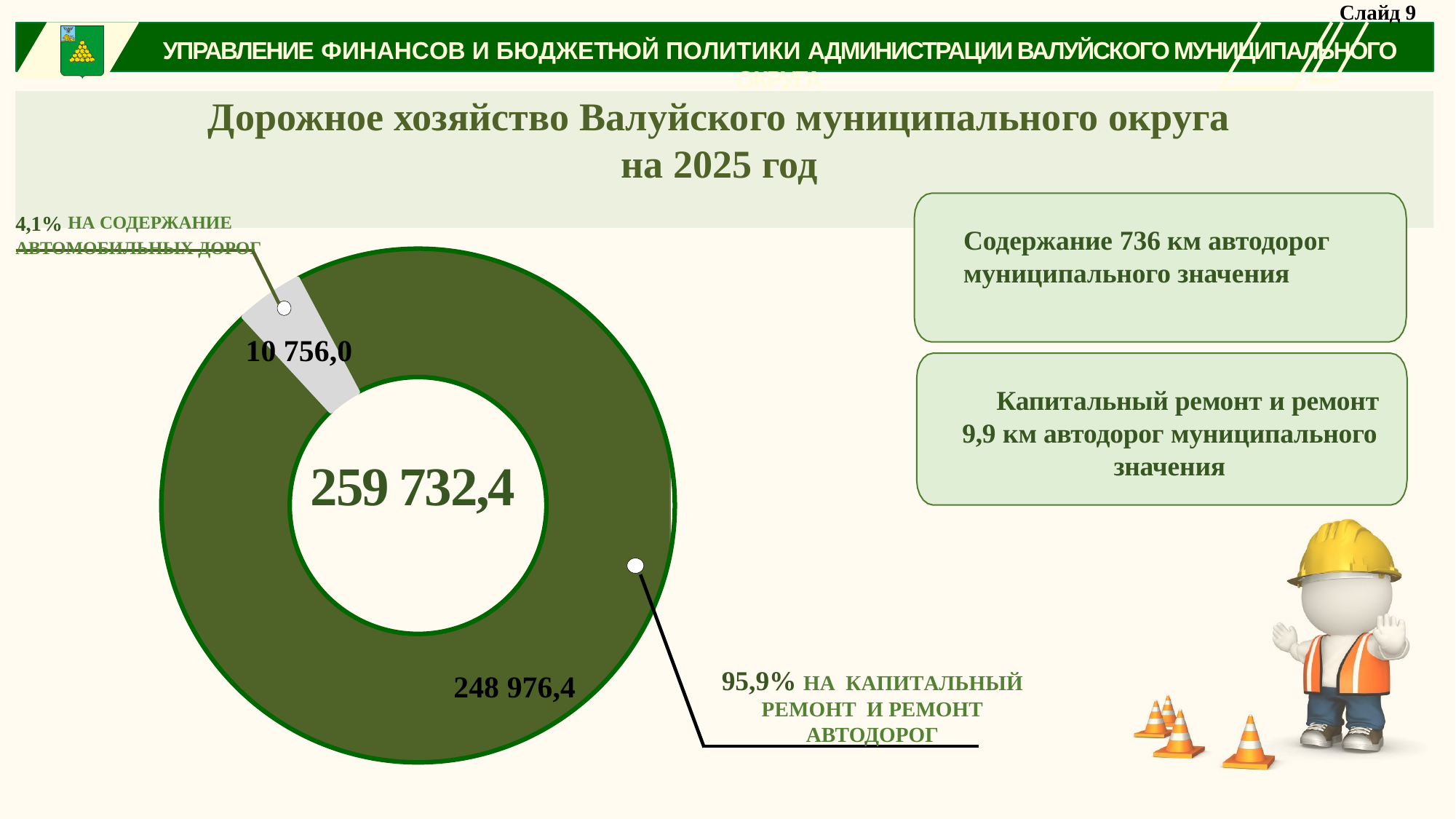
What value is shown for the segment labelled "на содержание автомобильных дорог"? 10 756,0 What value is shown for the segment labelled "на капитальный ремонт и ремонт автодорог"? 248 976,4 What is the difference between the value for капитальный ремонт и ремонт автодорог and the value for содержание автомобильных дорог? 238 220,4 Which is larger: the value for содержание автомобильных дорог or the value for капитальный ремонт и ремонт автодорог? Капитальный ремонт и ремонт автодорог What colour is the segment for содержание автомобильных дорог in the donut chart? Grey Which segment of the donut chart is the largest? Капитальный ремонт и ремонт автодорог What total value is printed in the centre of the donut chart? 259 732,4 What share of the donut chart goes to капитальный ремонт и ремонт автодорог? 95,9% Which segment of the donut chart is the smallest? Содержание автомобильных дорог What kind of chart is shown on the slide? Donut (pie) chart How many segments does the donut chart have? 2 What share of the donut chart goes to содержание автомобильных дорог? 4,1%